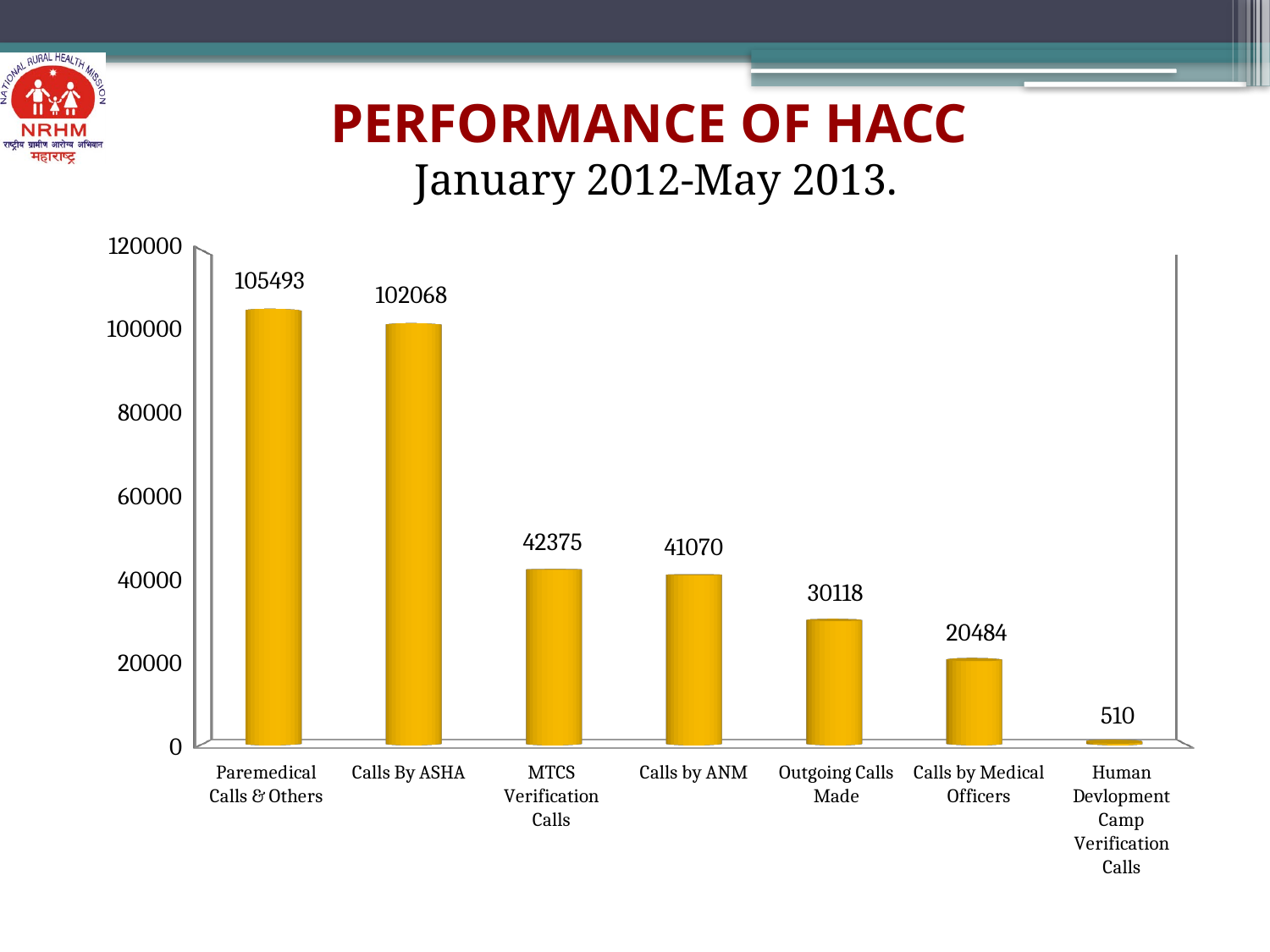
Which category has the highest value? Paremedical Calls & Others What is the value for Human Devlopment Camp Verification Calls? 510 What period does the chart cover, according to the slide subtitle? January 2012-May 2013 What is the value for Outgoing Calls Made? 30118 Which category has the lowest value? Human Devlopment Camp Verification Calls What kind of chart is shown on the slide? bar chart Which is larger, Outgoing Calls Made or Calls by Medical Officers? Outgoing Calls Made What is the difference between MTCS Verification Calls and Calls by ANM? 1305 What is the value for Calls By ASHA? 102068 What is the difference between Paremedical Calls & Others and Calls By ASHA? 3425 How many categories are shown in the chart? 7 Is the value for Calls by ANM greater or less than 40000? greater